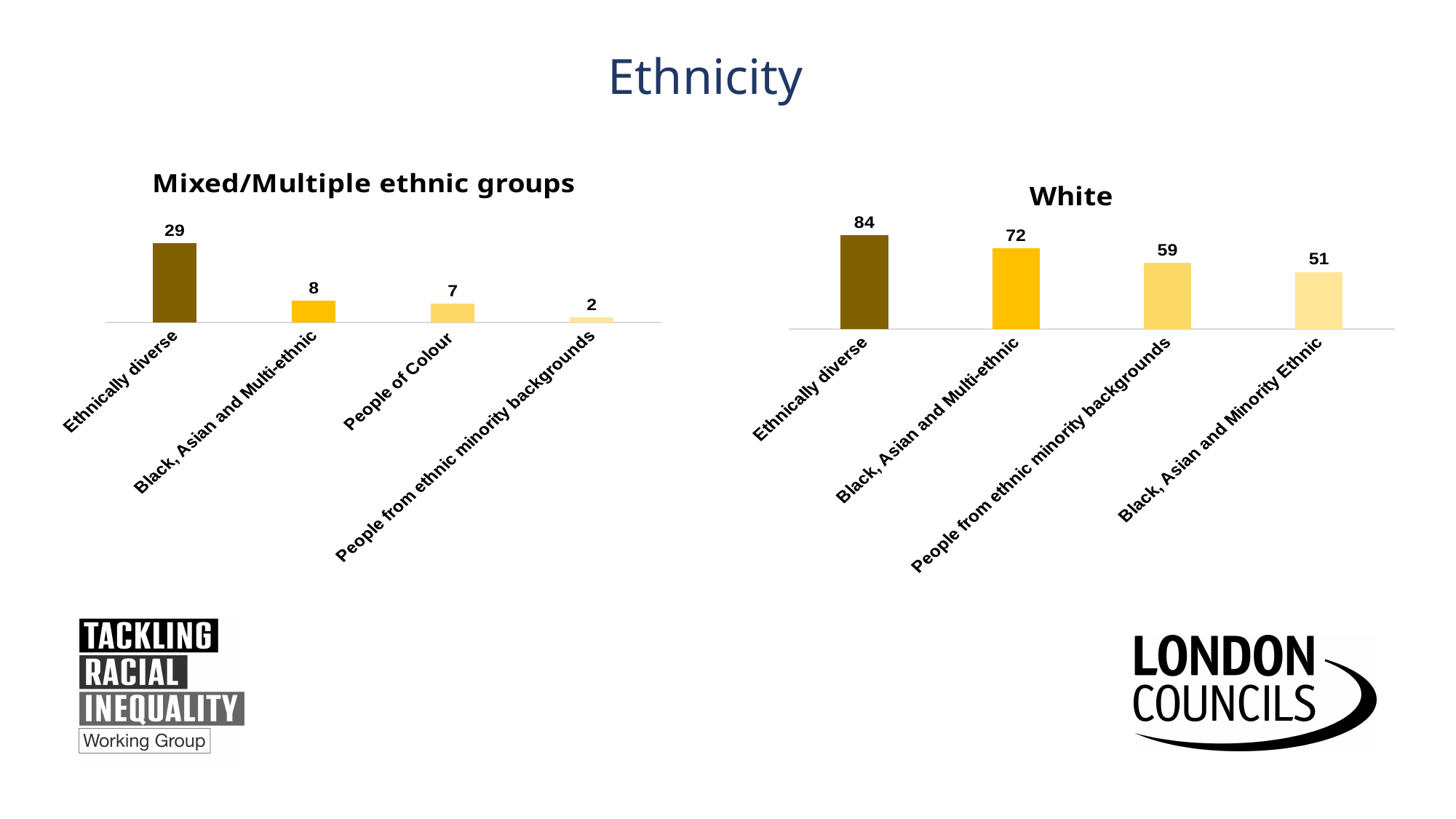
How many categories are shown in the 'White' chart? 4 In the 'Mixed/Multiple ethnic groups' chart, which category has the lowest value? People from ethnic minority backgrounds In the 'White' chart, what is the difference between the values for 'Ethnically diverse' and 'Black, Asian and Multi-ethnic'? 12 In the 'White' chart, what is the value for 'People from ethnic minority backgrounds'? 59 In the 'Mixed/Multiple ethnic groups' chart, what is the difference between the values for 'Black, Asian and Multi-ethnic' and 'People of Colour'? 1 In the 'White' chart, what is the value for 'Black, Asian and Minority Ethnic'? 51 In the 'White' chart, do the values rise or fall from left to right along the x axis? Fall In the 'Mixed/Multiple ethnic groups' chart, which is larger: the value for 'Ethnically diverse' or the value for 'People of Colour'? Ethnically diverse What is the title of the chart on the right side of the slide? White In the 'White' chart, which category has the highest value? Ethnically diverse What kind of chart is the 'Mixed/Multiple ethnic groups' chart? Bar chart In the 'Mixed/Multiple ethnic groups' chart, what is the value for 'Ethnically diverse'? 29